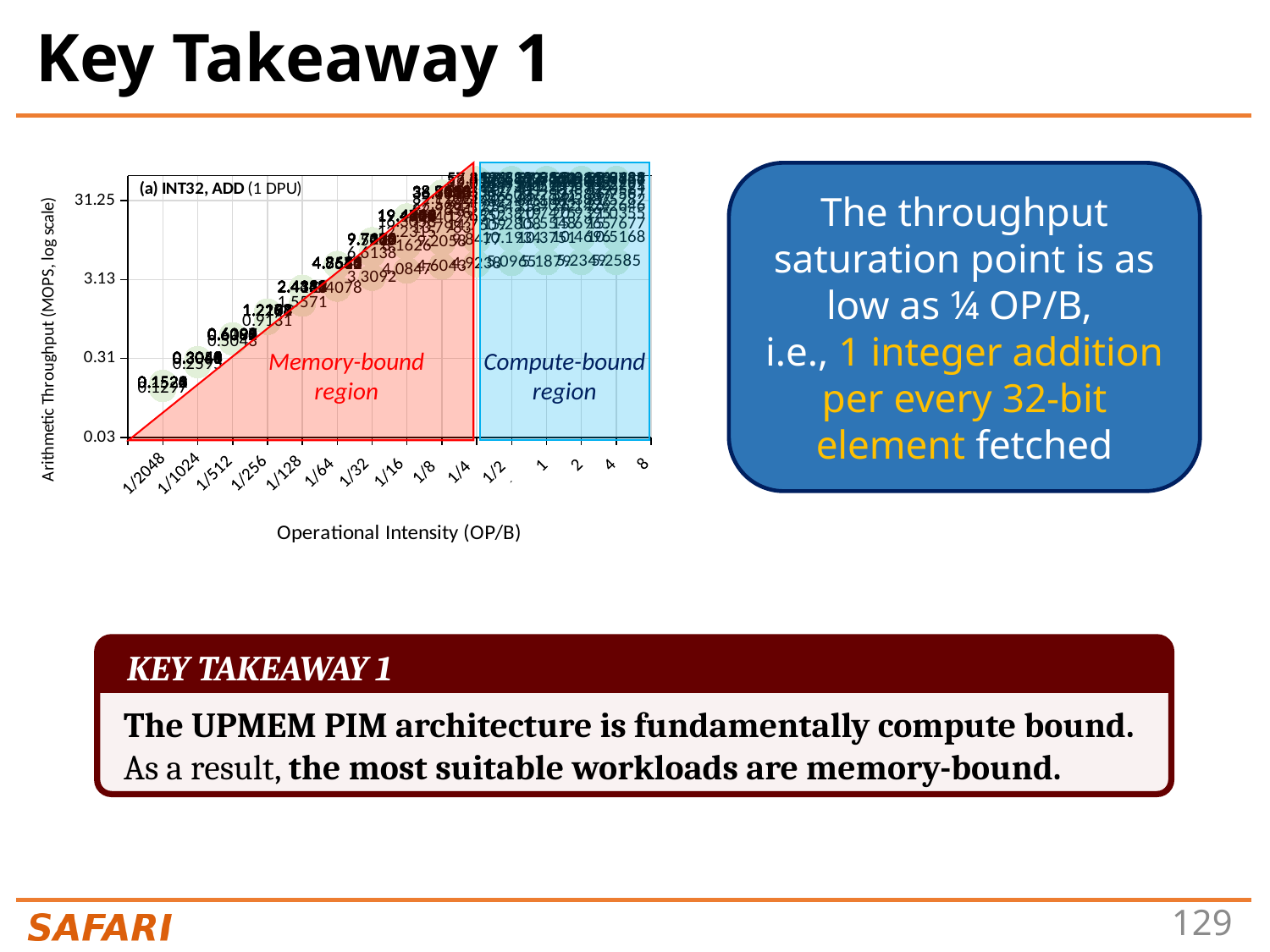
What kind of chart is shown on the slide? scatter plot What is the label of the chart's x axis? Operational Intensity (OP/B) Is the arithmetic throughput at an operational intensity of 1/2048 greater or less than 0.31 MOPS? less What is the highest tick value shown on the chart's y axis? 31.25 How many tick labels are shown along the chart's x axis? 15 Is the arithmetic throughput at an operational intensity of 1/128 greater or less than 0.31 MOPS? greater Which has higher arithmetic throughput: operational intensity 1/1024 or operational intensity 1/16? 1/16 How does arithmetic throughput change as operational intensity increases from 1/2048 to 1/4? It rises Is the arithmetic throughput at an operational intensity of 8 greater or less than 3.13 MOPS? greater What is the title shown inside the chart's plot area? (a) INT32, ADD (1 DPU)